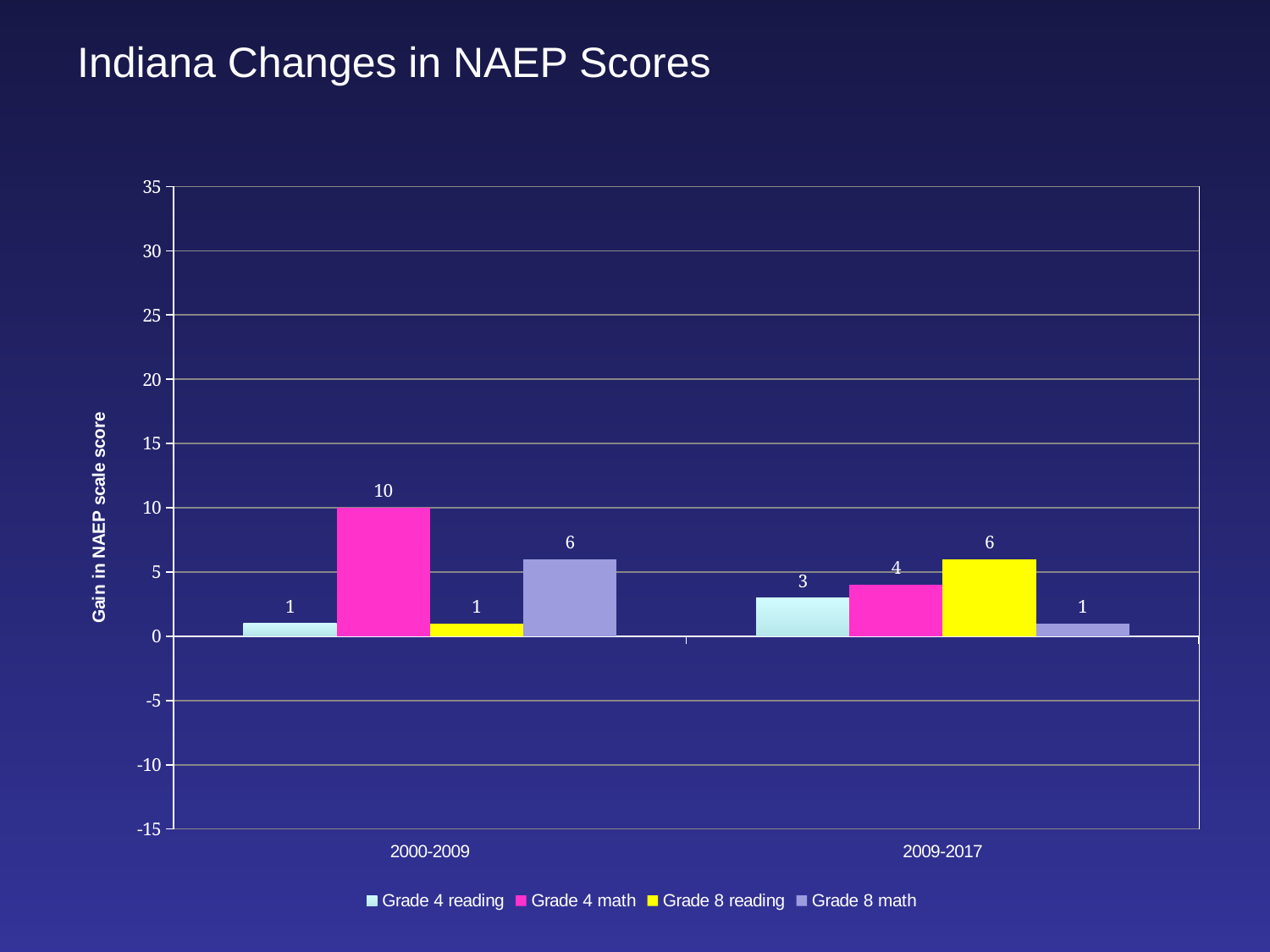
What is the gain in NAEP scale score for Grade 8 reading in 2009-2017? 6 Which series has the highest gain in the 2000-2009 period? Grade 4 math Is the value for Grade 4 math in 2000-2009 greater or less than 5? greater What is the gain in NAEP scale score for Grade 8 math in 2000-2009? 6 What is the difference between the Grade 4 math gain in 2000-2009 and in 2009-2017? 6 How many series does the legend list? 4 What is the gain in NAEP scale score for Grade 4 math in 2000-2009? 10 What is the label of the vertical axis? Gain in NAEP scale score Which is larger: the Grade 8 reading gain in 2000-2009 or in 2009-2017? 2009-2017 What is the gain in NAEP scale score for Grade 4 reading in 2009-2017? 3 What kind of chart is shown on the slide? Bar chart Which series has the lowest gain in the 2009-2017 period? Grade 8 math